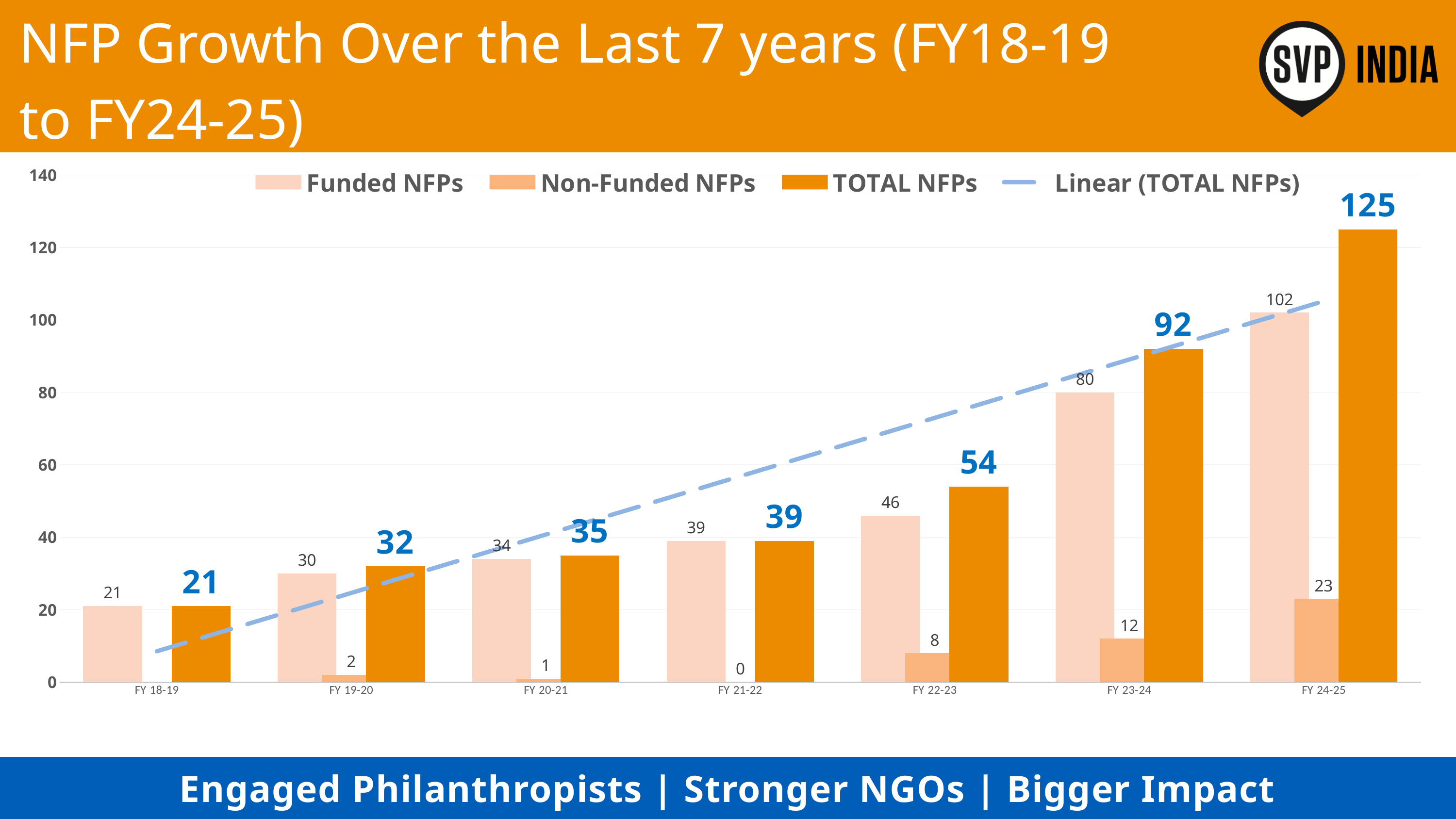
What is the value of Funded NFPs for FY 23-24? 80 Do the TOTAL NFPs values rise or fall from FY 18-19 to FY 24-25? Rise Which is larger: Funded NFPs in FY 21-22 or Funded NFPs in FY 22-23? Funded NFPs in FY 22-23 Which fiscal year has the highest TOTAL NFPs? FY 24-25 What is the difference between TOTAL NFPs in FY 24-25 and FY 23-24? 33 What is the name of the dashed line series in the legend? Linear (TOTAL NFPs) How many entries does the legend list? 4 What is the value of TOTAL NFPs for FY 24-25? 125 How many fiscal years are shown on the x axis? 7 What kind of chart is shown on the slide? Bar chart Which fiscal year has the lowest Funded NFPs? FY 18-19 What is the value of Non-Funded NFPs for FY 22-23? 8